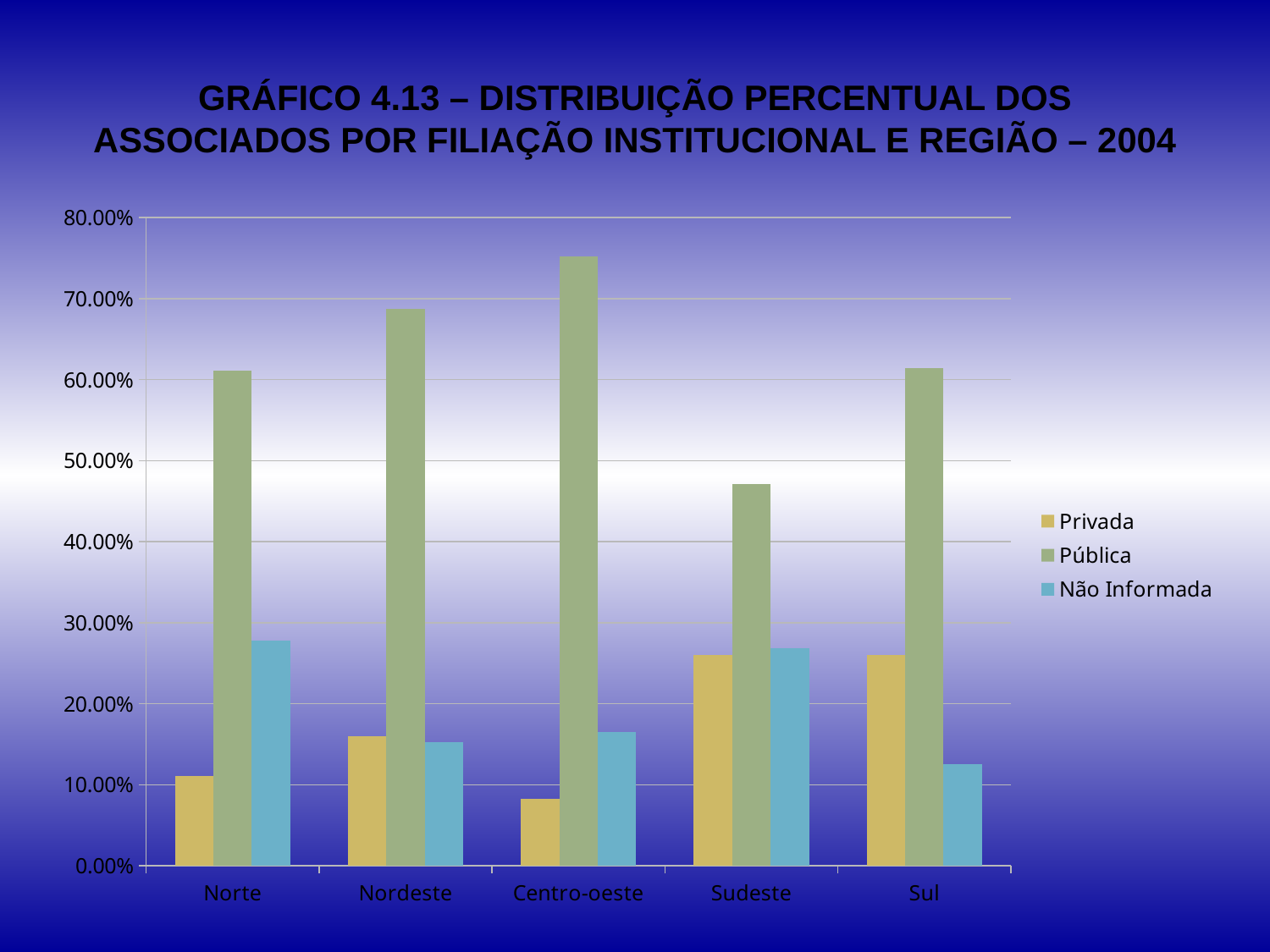
Is the value for Não Informada in Norte greater or less than 20.00%? greater How many regions are shown on the x axis? 5 Which region has the highest value for Pública? Centro-oeste Is the value for Pública in Centro-oeste greater or less than 70.00%? greater What kind of chart is shown on the slide? bar chart Which region has the lowest value for Pública? Sudeste Is the value for Privada in Centro-oeste greater or less than 10.00%? less Which region has the lowest value for Privada? Centro-oeste Which is larger: the Pública value for Norte or the Pública value for Sudeste? Norte Which series is shown in green in the legend? Pública How many series does the legend list? 3